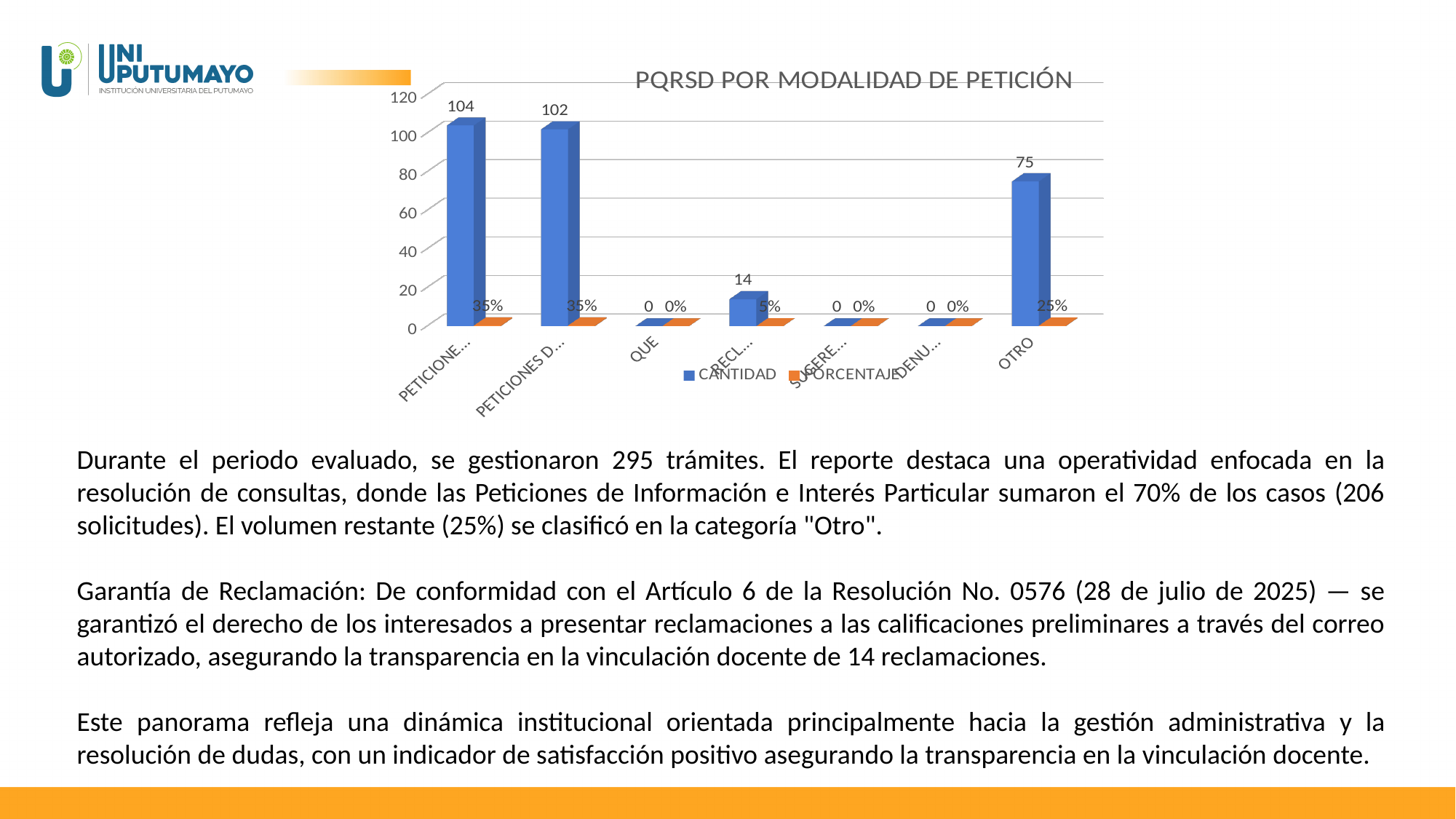
What is the CANTIDAD value for the second category on the x axis? 102 What is the title of the chart? PQRSD POR MODALIDAD DE PETICIÓN Which is larger, the CANTIDAD for the fourth category (RECL...) or for OTRO? OTRO What is the PORCENTAJE value for the OTRO category? 25% How many series does the chart legend list? 2 What is the CANTIDAD value for the first category on the x axis? 104 What type of chart is shown on the slide? bar chart Which colour represents the PORCENTAJE series in the chart? orange What is the difference in CANTIDAD between the first category and the OTRO category? 29 How many categories are shown on the x axis of the chart? 7 Which category has the highest CANTIDAD value? the first category (PETICIONE...) What is the CANTIDAD value for the OTRO category? 75